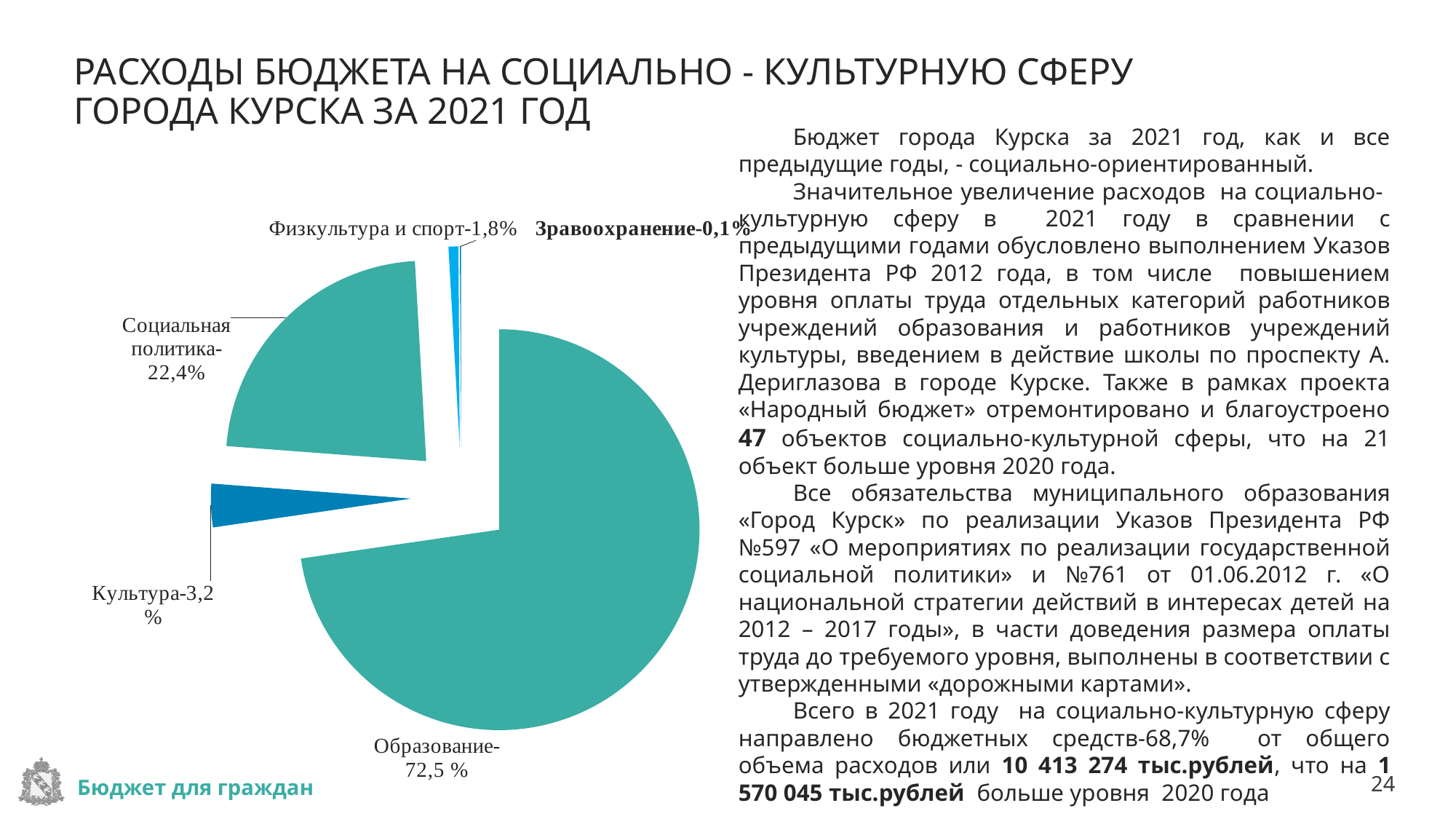
What share of the pie chart is Культура? 3,2 % Which category is shown in the dark blue slice of the pie chart? Культура What share of the pie chart is Образование? 72,5 % What share of the pie chart is Социальная политика? 22,4% Which category has the largest slice in the pie chart? Образование By how many percentage points does the Образование share exceed the Социальная политика share? 50,1 What share of the pie chart is Физкультура и спорт? 1,8% How many slices does the pie chart have? 5 What kind of chart is shown on the slide? pie chart What share of the pie chart is Здравоохранение? 0,1% Which slice is larger: Социальная политика or Культура? Социальная политика Which category has the smallest slice in the pie chart? Здравоохранение